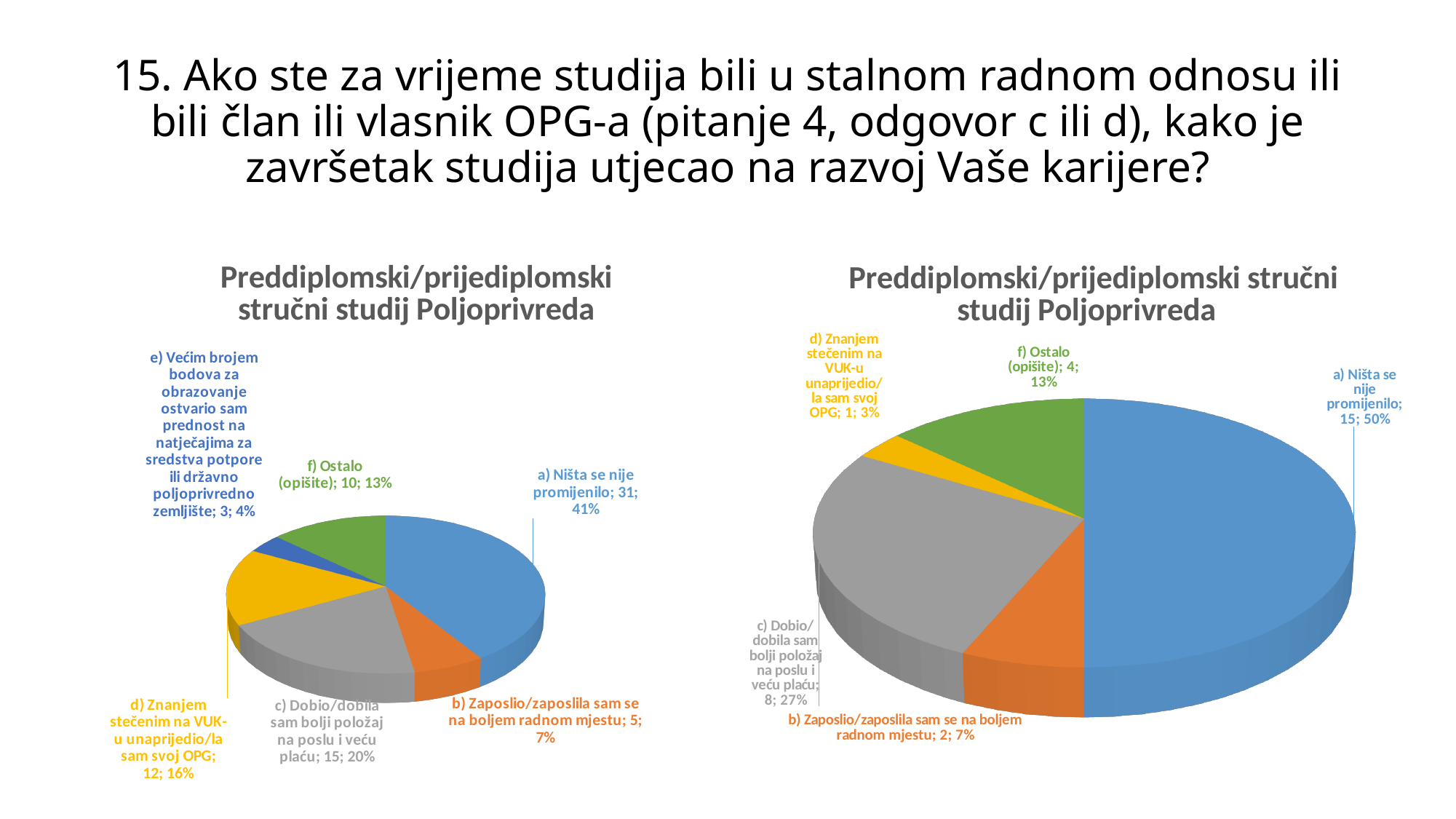
How many slices does the right pie chart have? 5 How many slices does the left pie chart have? 6 In the right pie chart, how many respondents chose "c) Dobio/dobila sam bolji položaj na poslu i veću plaću"? 8 What type of chart is shown on the right side of the slide? Pie chart In the left pie chart, what is the difference in count between "a) Ništa se nije promijenilo" and "c) Dobio/dobila sam bolji položaj na poslu i veću plaću"? 16 In the left pie chart, what is the count for "d) Znanjem stečenim na VUK-u unaprijedio/la sam svoj OPG"? 12 In the right pie chart, which is larger: "f) Ostalo (opišite)" or "b) Zaposlio/zaposlila sam se na boljem radnom mjestu"? f) Ostalo (opišite) In the left pie chart, which category has the smallest slice? e) Većim brojem bodova za obrazovanje ostvario sam prednost na natječajima za sredstva potpore ili državno poljoprivredno zemljište In the right pie chart, which category has the largest slice? a) Ništa se nije promijenilo In the left pie chart, how many respondents chose "a) Ništa se nije promijenilo"? 31 In the right pie chart, what percentage share does "a) Ništa se nije promijenilo" have? 50% In the left pie chart, what percentage share does "c) Dobio/dobila sam bolji položaj na poslu i veću plaću" have? 20%